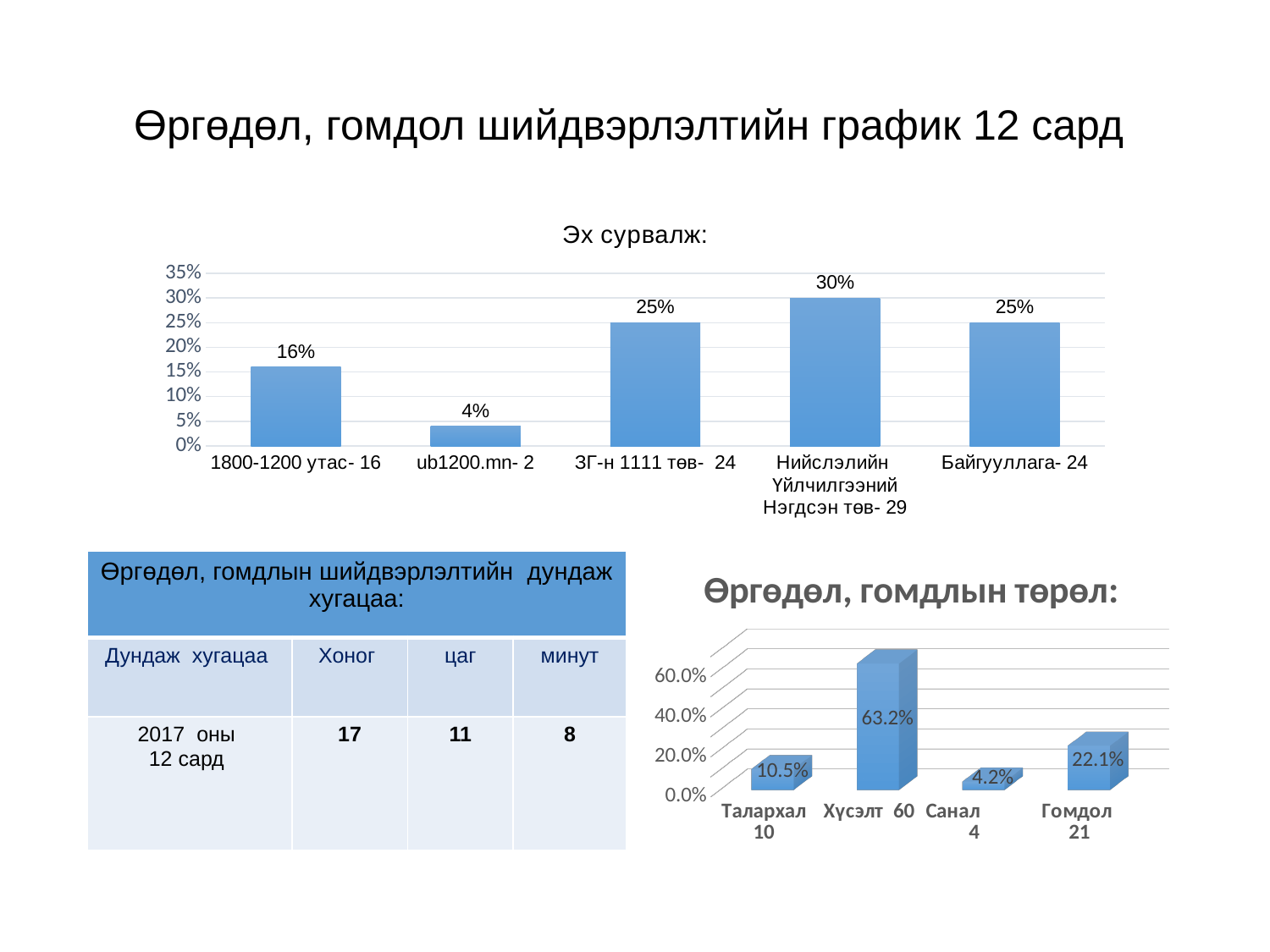
In the "Өргөдөл, гомдлын төрөл:" chart, which is larger, the value for "Талархал 10" or "Гомдол 21"? Гомдол 21 In the "Эх сурвалж:" chart, what is the value for "Нийслэлийн Үйлчилгээний Нэгдсэн төв- 29"? 30% In the "Эх сурвалж:" chart, what is the difference between the values for "Нийслэлийн Үйлчилгээний Нэгдсэн төв- 29" and "1800-1200 утас- 16"? 14% In the "Эх сурвалж:" chart, which category has the lowest value? ub1200.mn- 2 In the "Эх сурвалж:" chart, how many categories are shown? 5 In the "Өргөдөл, гомдлын төрөл:" chart, what is the value for "Гомдол 21"? 22.1% In the "Эх сурвалж:" chart, which category has the highest value? Нийслэлийн Үйлчилгээний Нэгдсэн төв- 29 In the "Өргөдөл, гомдлын төрөл:" chart, which category has the lowest value? Санал 4 In the "Эх сурвалж:" chart, what is the value for "ub1200.mn- 2"? 4% In the "Өргөдөл, гомдлын төрөл:" chart, how many categories are shown? 4 In the "Өргөдөл, гомдлын төрөл:" chart, what is the value for "Хүсэлт 60"? 63.2% What kind of chart is the "Эх сурвалж:" chart? bar chart